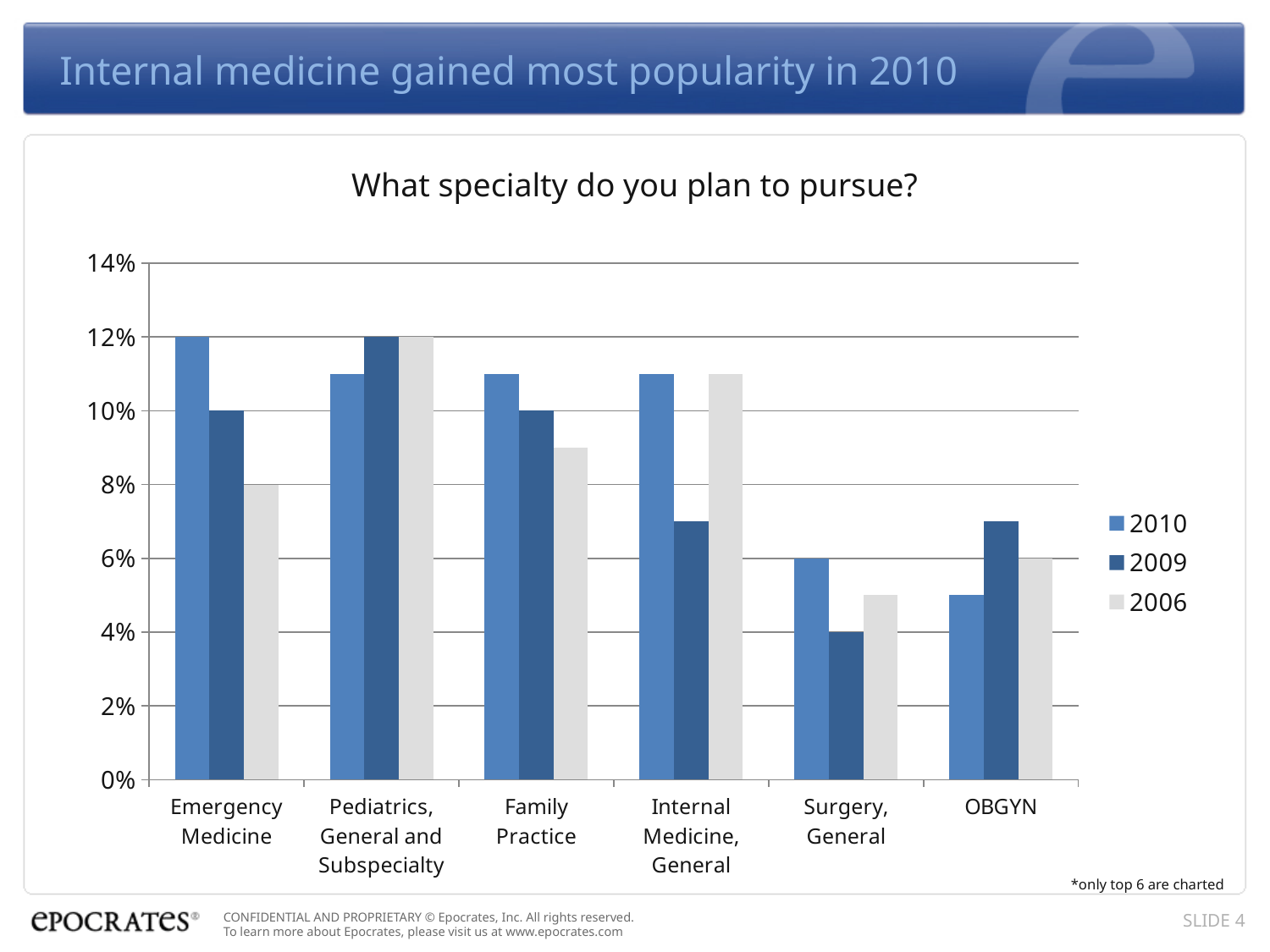
For Internal Medicine, General, which is larger: the 2010 value or the 2009 value? 2010 How many series does the chart legend list? 3 What is the 2009 value for Surgery, General? 4% Which specialty has the highest 2010 value? Emergency Medicine What is the difference between the 2010 and 2006 values for Emergency Medicine? 4 percentage points Is the 2009 value for Internal Medicine, General greater or less than 8%? less What type of chart is shown on the slide? Bar chart Which specialty has the lowest 2009 value? Surgery, General What is the 2006 value for Emergency Medicine? 8% What is the title of the chart? What specialty do you plan to pursue? How many specialties are shown on the x axis of the chart? 6 What is the 2010 value for Emergency Medicine? 12%